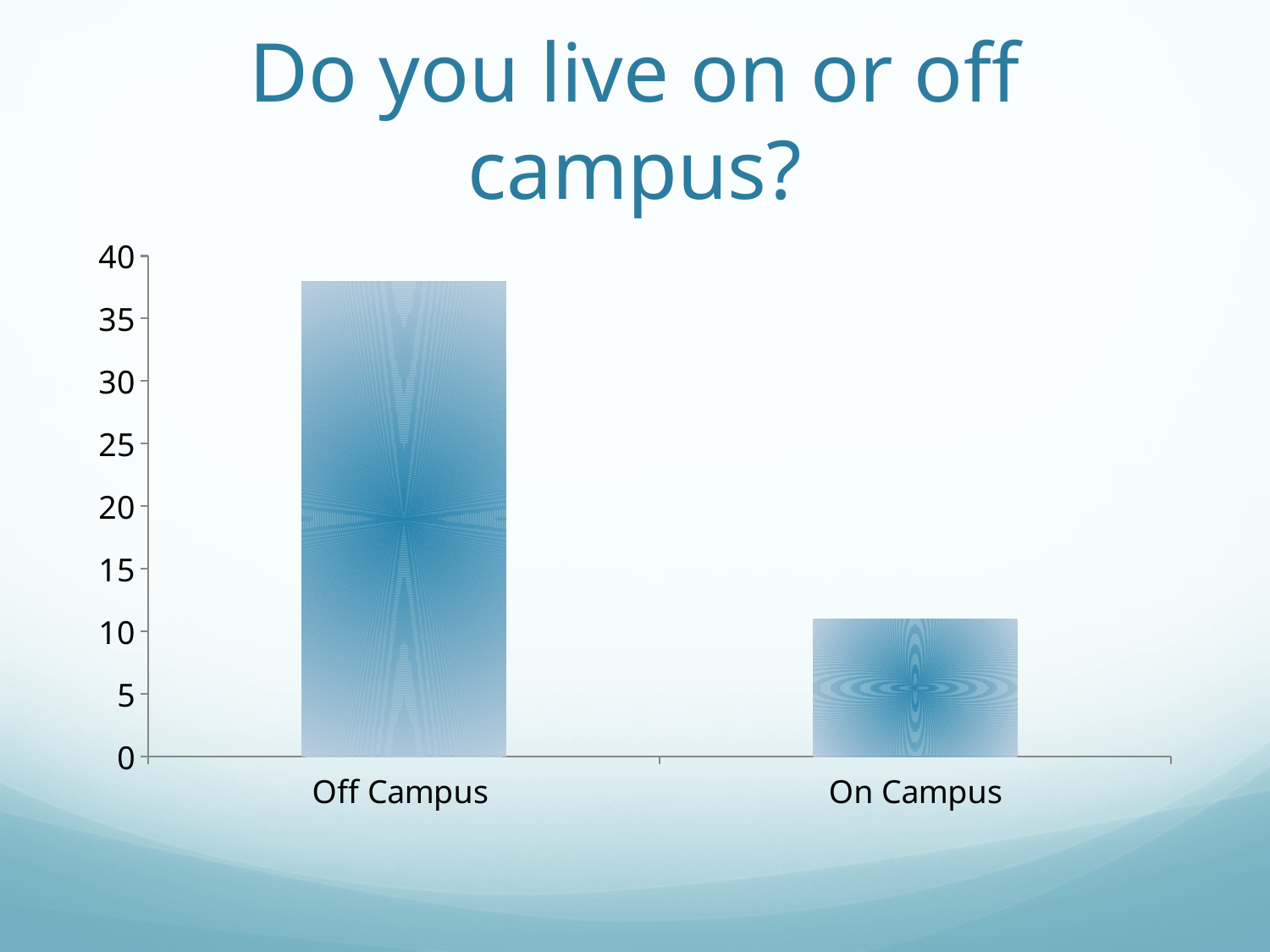
Is the value for Off Campus greater or less than 30? greater What kind of chart is shown on the slide? bar chart Which category has the lowest value in the chart? On Campus What is the highest value shown on the y axis of the chart? 40 Which category has the highest value in the chart? Off Campus Is the value for Off Campus greater or less than 35? greater Is the value for On Campus greater or less than 5? greater What is the title of the chart on the slide? Do you live on or off campus? How many categories are shown on the x axis of the chart? 2 Which is larger, the value for Off Campus or the value for On Campus? Off Campus